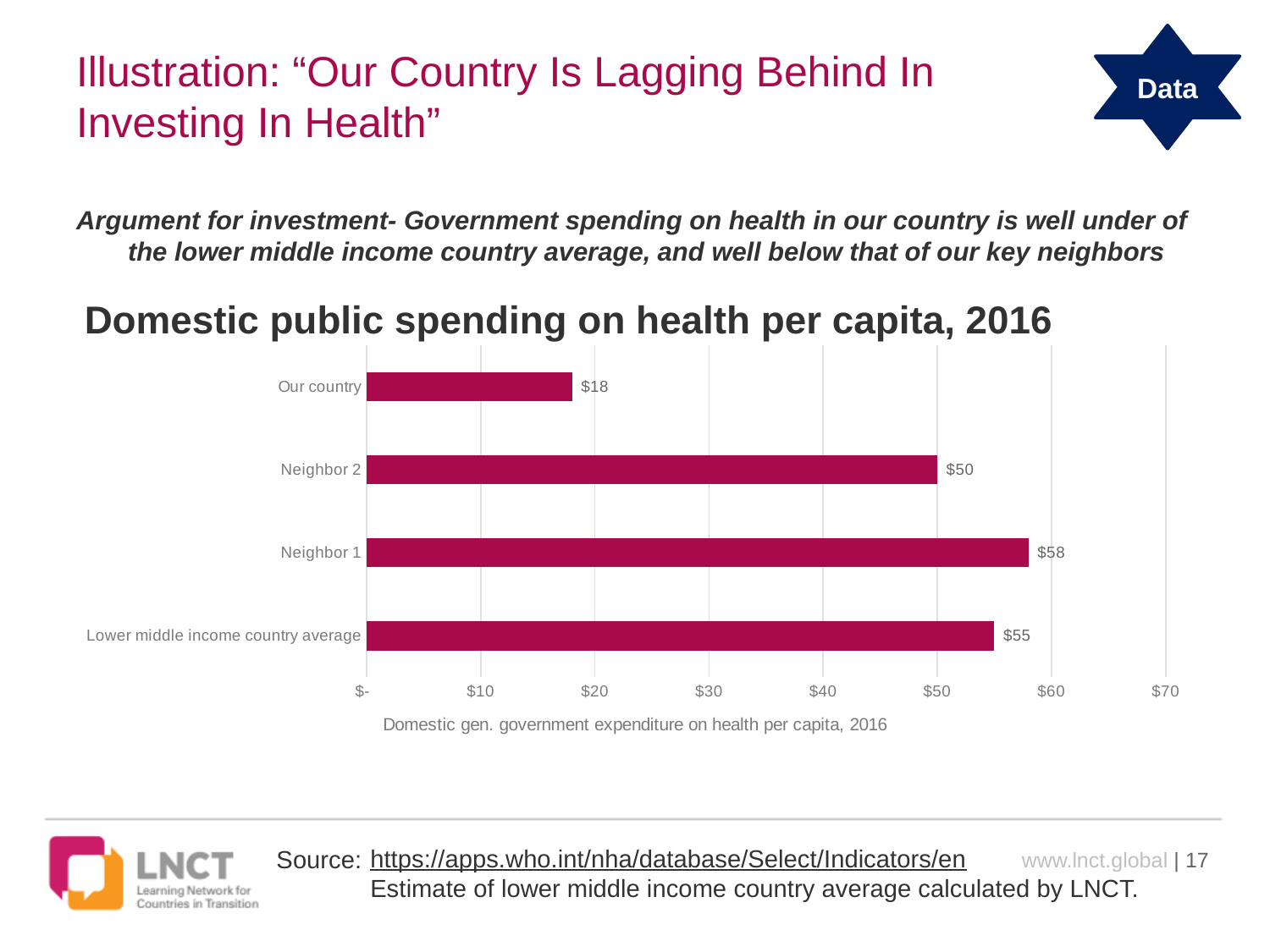
How many categories are shown in the chart? 4 What is the difference between Neighbor 1 and Our country? $40 What is the difference between the Lower middle income country average and Neighbor 2? $5 Which category has the lowest domestic public spending on health per capita? Our country Is the value for Neighbor 1 greater or less than $50? greater What is the domestic public spending on health per capita for Our country? $18 Which category has the highest domestic public spending on health per capita? Neighbor 1 What is the value shown for Neighbor 1? $58 What is the value shown for the Lower middle income country average? $55 What kind of chart is shown on the slide? Bar chart Which is larger, the value for Neighbor 2 or the value for Our country? Neighbor 2 What is the title of the chart? Domestic public spending on health per capita, 2016